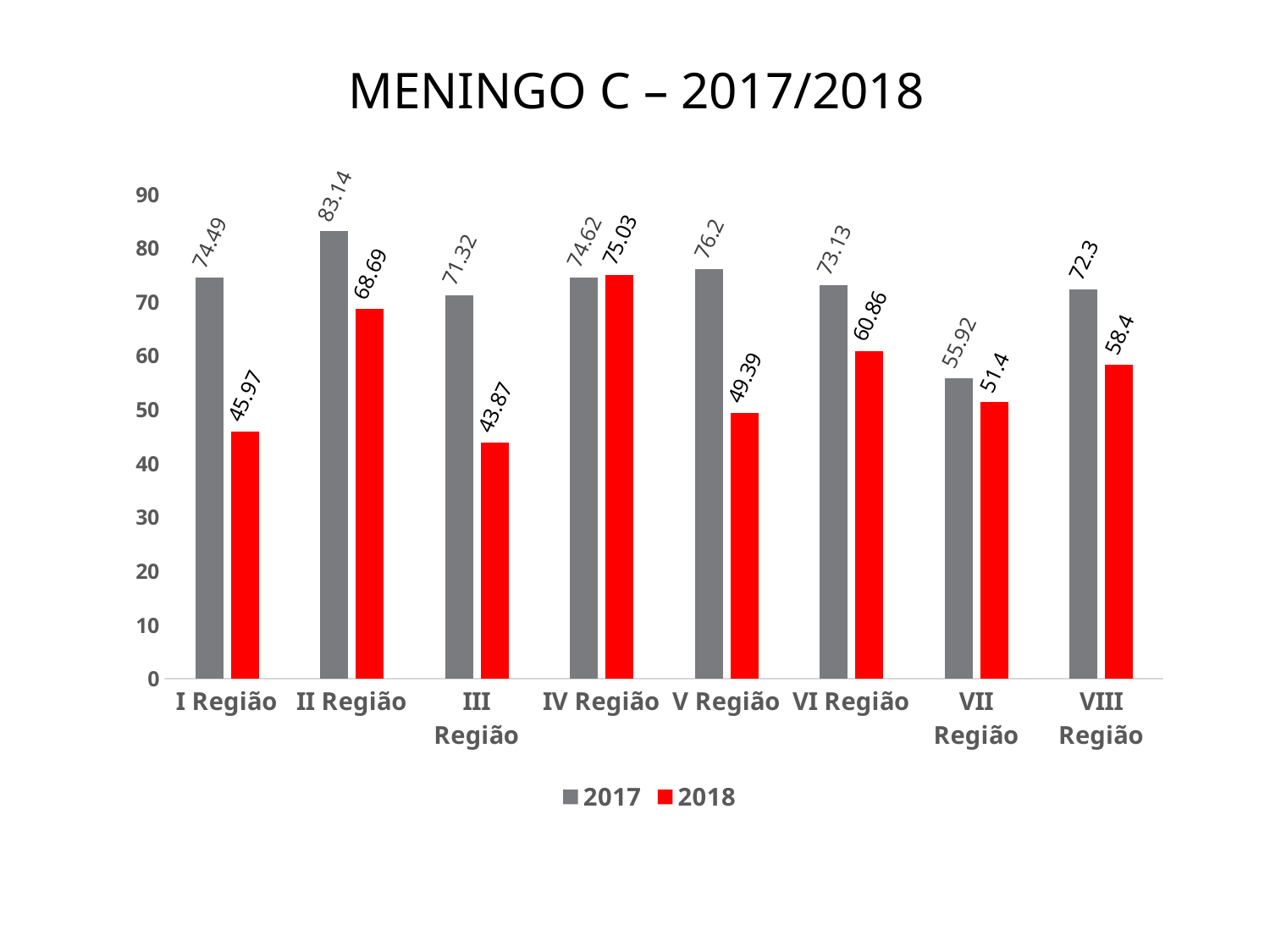
What is the 2017 value for II Região? 83.14 What kind of chart is shown? Bar chart What is the title of the chart? MENINGO C – 2017/2018 Which region has the lowest 2018 value? III Região What is the 2018 value for III Região? 43.87 Which is larger for IV Região, the 2017 value or the 2018 value? 2018 What is the difference between the 2017 and 2018 values for I Região? 28.52 Which region has the lowest 2017 value? VII Região How many regions are shown on the x axis? 8 Which region has the highest 2017 value? II Região How many series does the legend list? 2 What is the 2018 value for VI Região? 60.86